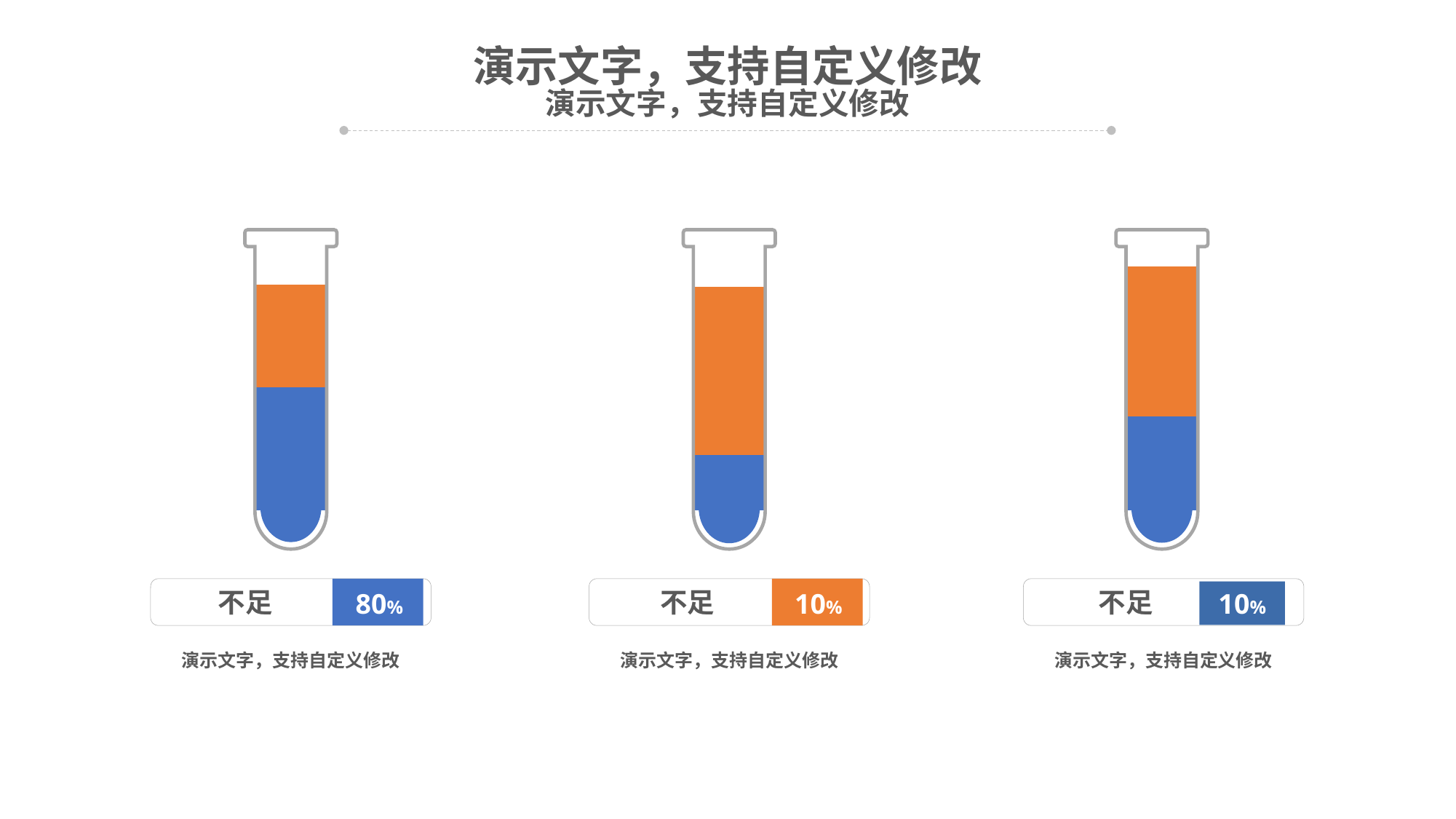
Which test tube has the smallest blue fill? The middle test tube What Chinese text appears in each label box next to the percentage? 不足 Which two colours are used to fill the test tubes? Orange and blue How many test tubes are shown on the slide? 3 Is the percentage printed under the left test tube larger or smaller than the percentage printed under the right test tube? Larger Which test tube has the highest printed percentage in its label? The left test tube (80%) Which test tube has the largest blue fill? The left test tube What percentage is printed in the label below the right test tube? 10% What is the difference between the percentage printed under the left test tube and the percentage printed under the middle test tube? 70% What percentage is printed in the label below the left test tube? 80% What percentage is printed in the label below the middle test tube? 10%